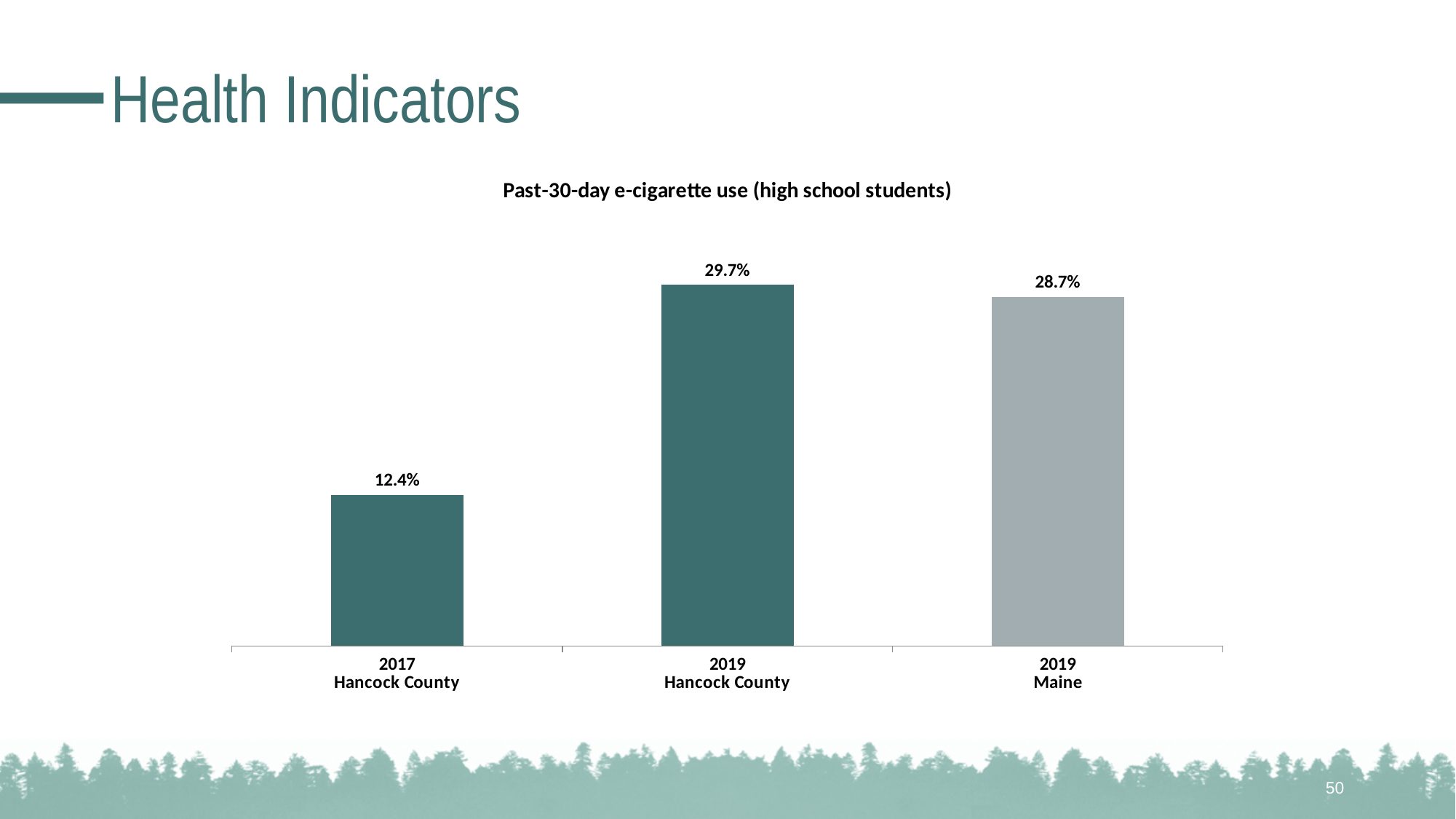
What is the value for 2019 Hancock County? 29.7% How many bars are shown in the chart? 3 What is the value for 2019 Maine? 28.7% What is the difference between the 2019 Hancock County value and the 2019 Maine value? 1.0% What is the difference between the 2019 Hancock County value and the 2017 Hancock County value? 17.3% What is the value for 2017 Hancock County? 12.4% Did the Hancock County value rise or fall from 2017 to 2019? Rise Which category has the highest value? 2019 Hancock County Which is larger, the value for 2019 Maine or the value for 2017 Hancock County? 2019 Maine What kind of chart is shown on the slide? Bar chart What is the title of the chart? Past-30-day e-cigarette use (high school students) Which category has the lowest value? 2017 Hancock County